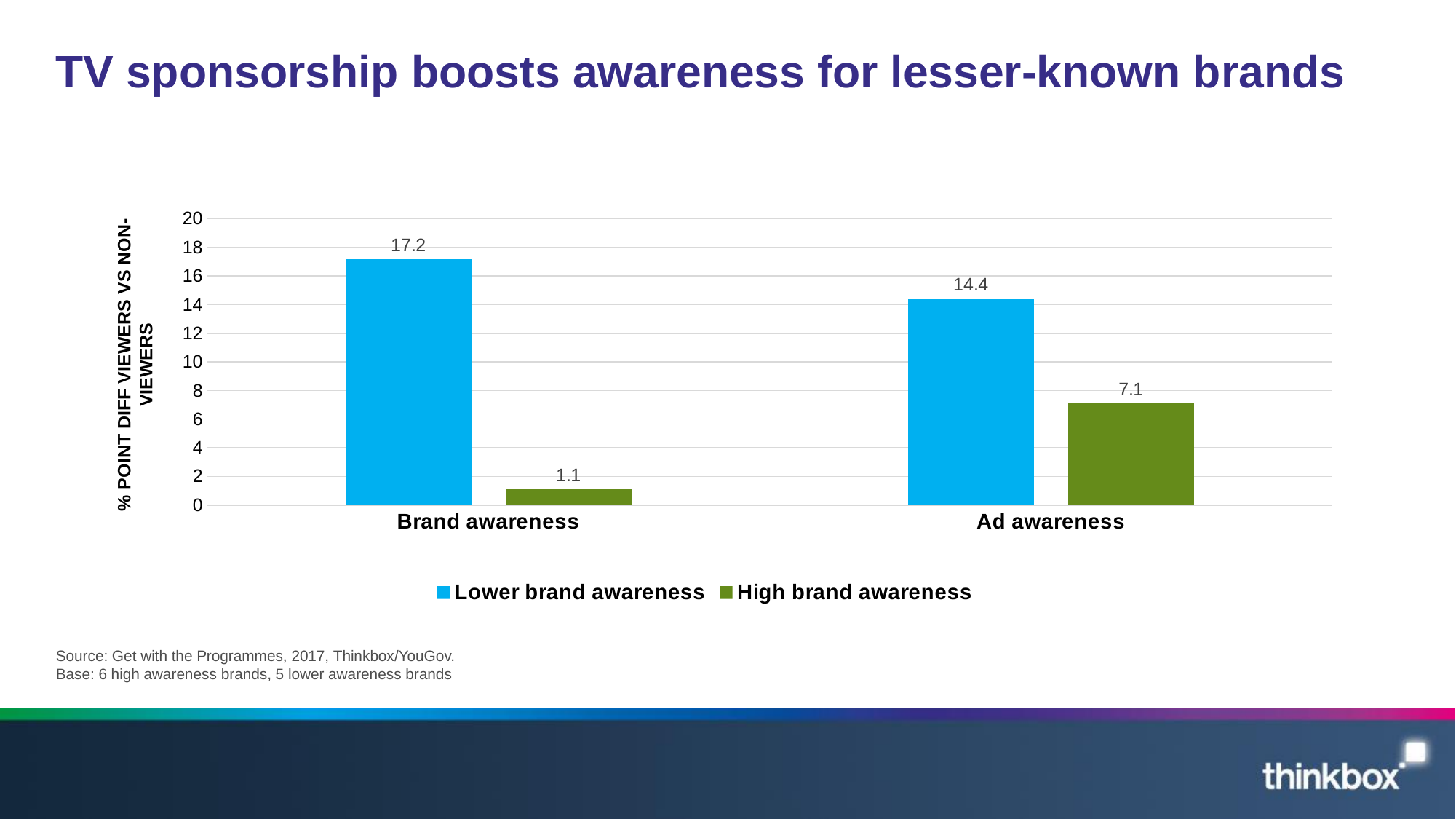
What is the value for Lower brand awareness in the Ad awareness category? 14.4 Which bar has the lowest value on the chart? High brand awareness, Brand awareness Which is larger: the Lower brand awareness value for Brand awareness or for Ad awareness? Brand awareness What is the value for Lower brand awareness in the Brand awareness category? 17.2 What is the difference between the Lower brand awareness and High brand awareness values in the Brand awareness category? 16.1 How many categories are shown on the x axis? 2 How many series does the legend list? 2 What is the value for High brand awareness in the Ad awareness category? 7.1 Which bar has the highest value on the chart? Lower brand awareness, Brand awareness What is the difference between the Lower brand awareness and High brand awareness values in the Ad awareness category? 7.3 What kind of chart is shown on the slide? Bar chart What is the value for High brand awareness in the Brand awareness category? 1.1